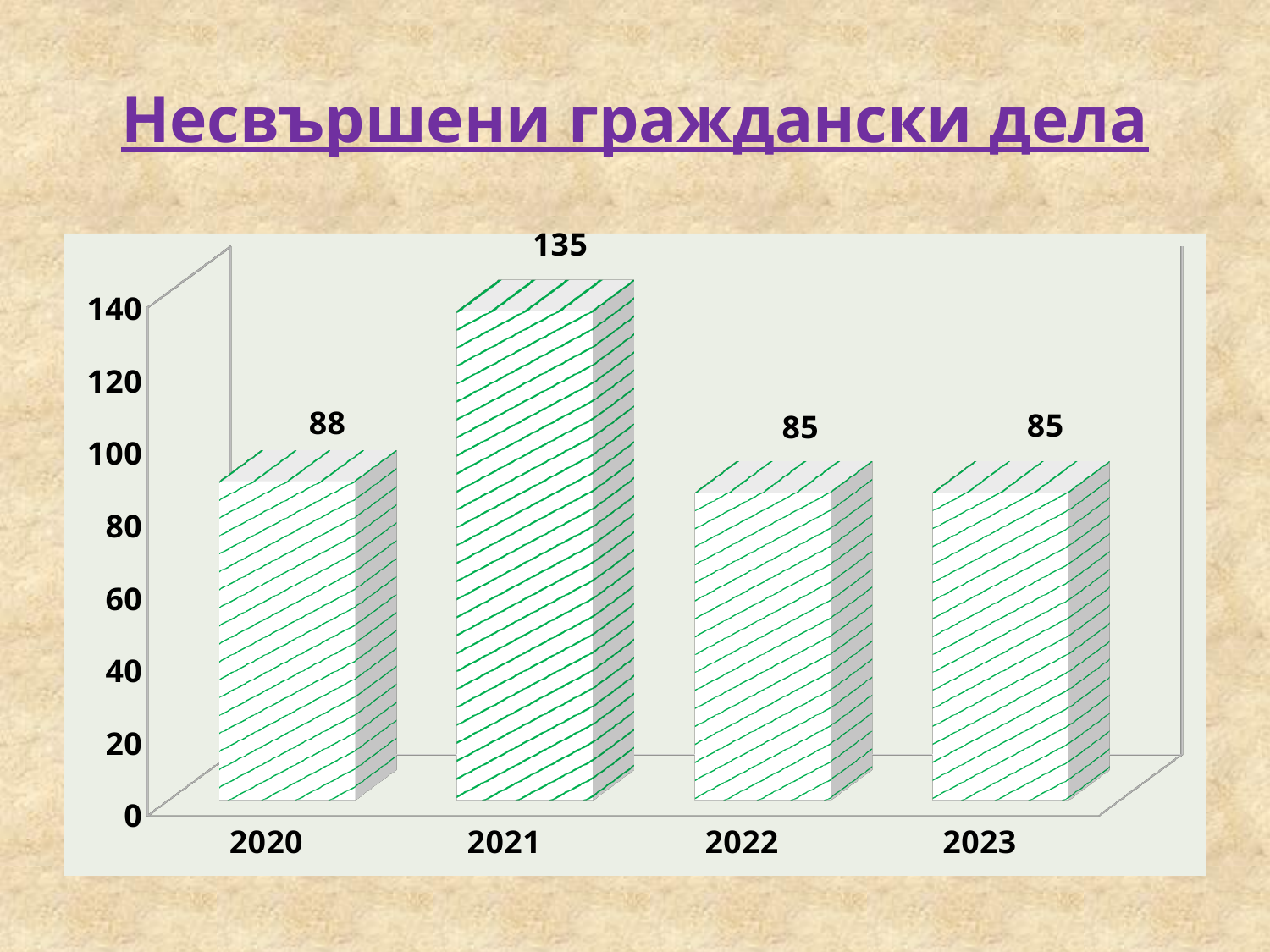
What is the value for 2021? 135 How many years are shown on the x axis? 4 Is the value for 2023 greater or less than 100? less What is the value for 2020? 88 What is the difference between the values for 2020 and 2022? 3 Is the value for 2021 greater or less than 120? greater Which year has the highest value? 2021 What is the value for 2023? 85 What kind of chart is shown on the slide? bar chart What is the difference between the values for 2021 and 2020? 47 What is the title of the slide? Несвършени граждански дела Which is larger, the value for 2020 or the value for 2022? 2020